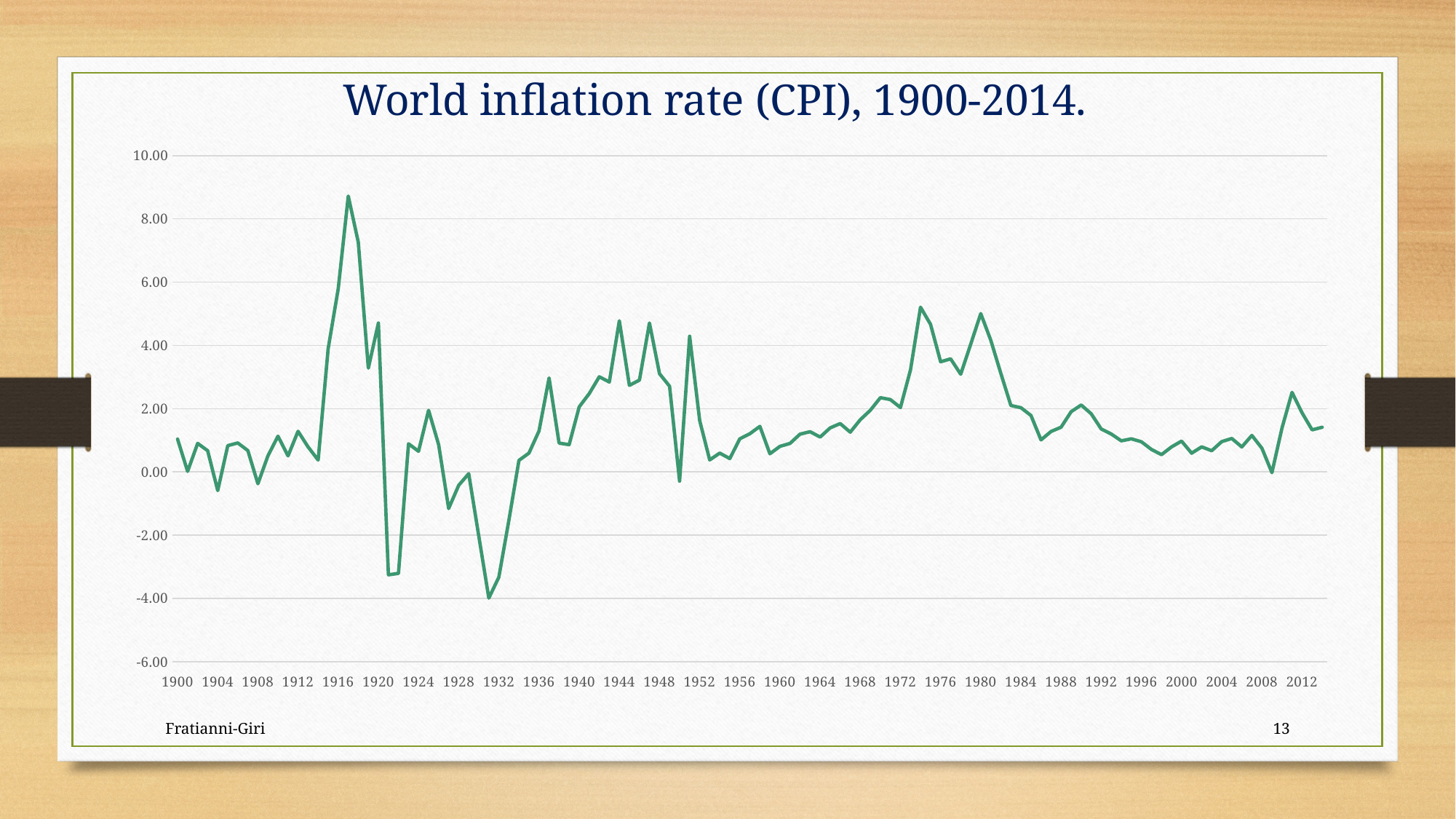
Is the value for 1932 greater or less than 0.00? less Do the values rise or fall from 1980 to 1984? fall What kind of chart is shown on the slide? line chart What is the title of the chart? World inflation rate (CPI), 1900-2014. Is the value for 1988 greater or less than 2.00? less Is the value for 1944 greater or less than 4.00? greater Which is larger, the value for 1944 or the value for 1952? 1944 Which is larger, the value for 1980 or the value for 1988? 1980